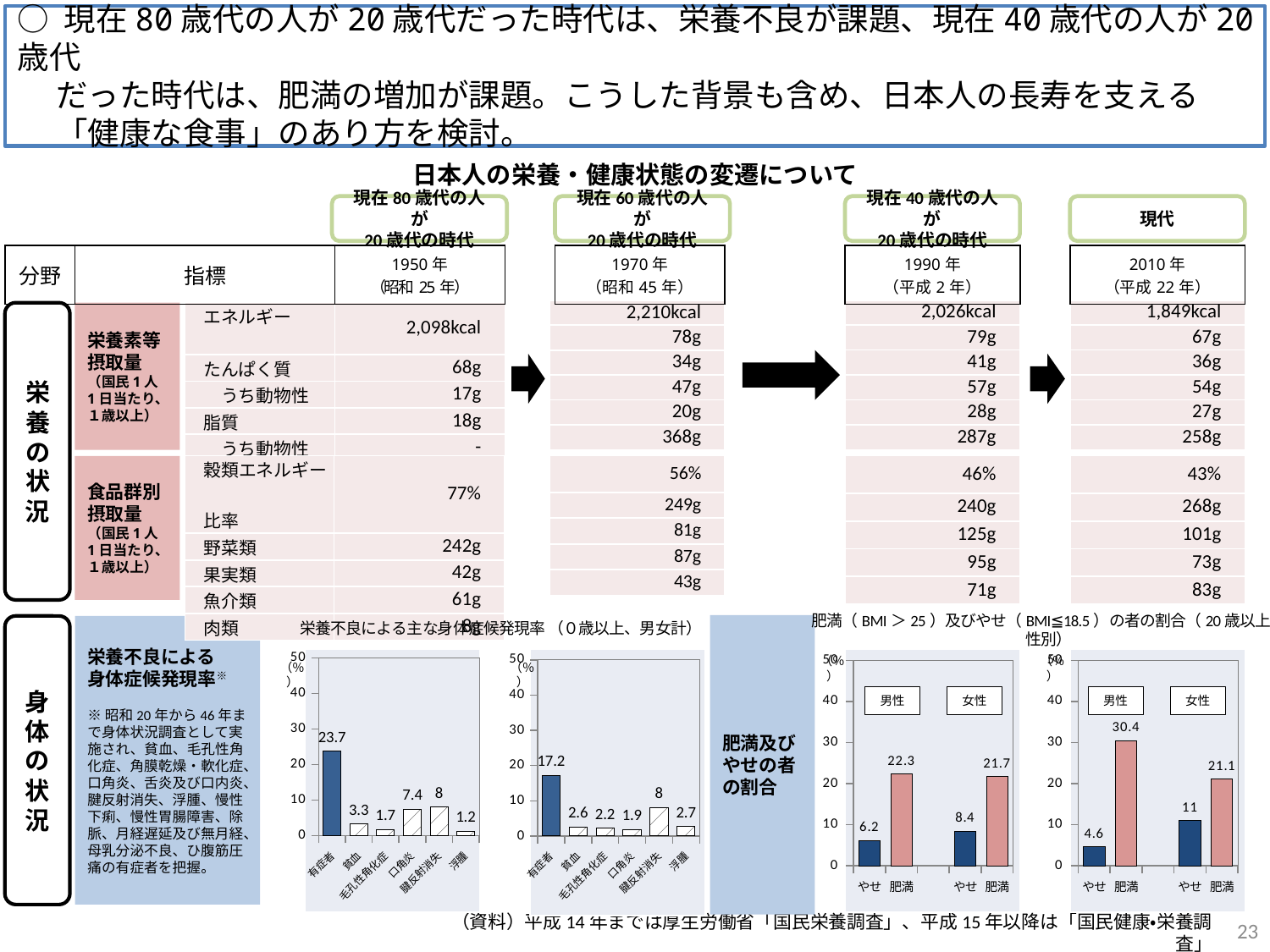
In the leftmost bar chart (1950 column), what is the value for 有症者? 23.7 What type of chart is the rightmost chart (2010 column)? bar chart In the rightmost bar chart (2010 column), what is the value for 肥満 among 男性? 30.4 In the second bar chart from the left (1970 column), what is the value for 有症者? 17.2 In the third bar chart from the left (1990 column), what is the value for 肥満 among 男性? 22.3 In the leftmost bar chart (1950 column), which category has the lowest value? 浮腫 In the rightmost bar chart (2010 column), is the value for 肥満 among 男性 greater or less than 30? greater In the second bar chart from the left (1970 column), which is larger, 貧血 or 浮腫? 浮腫 In the third bar chart from the left (1990 column), what is the difference between やせ for 女性 and やせ for 男性? 2.2 In the second bar chart from the left (1970 column), what is the difference between 有症者 and 腱反射消失? 9.2 In the rightmost bar chart (2010 column), which is larger, やせ for 女性 or やせ for 男性? 女性 In the leftmost bar chart (1950 column), how many categories are plotted? 6